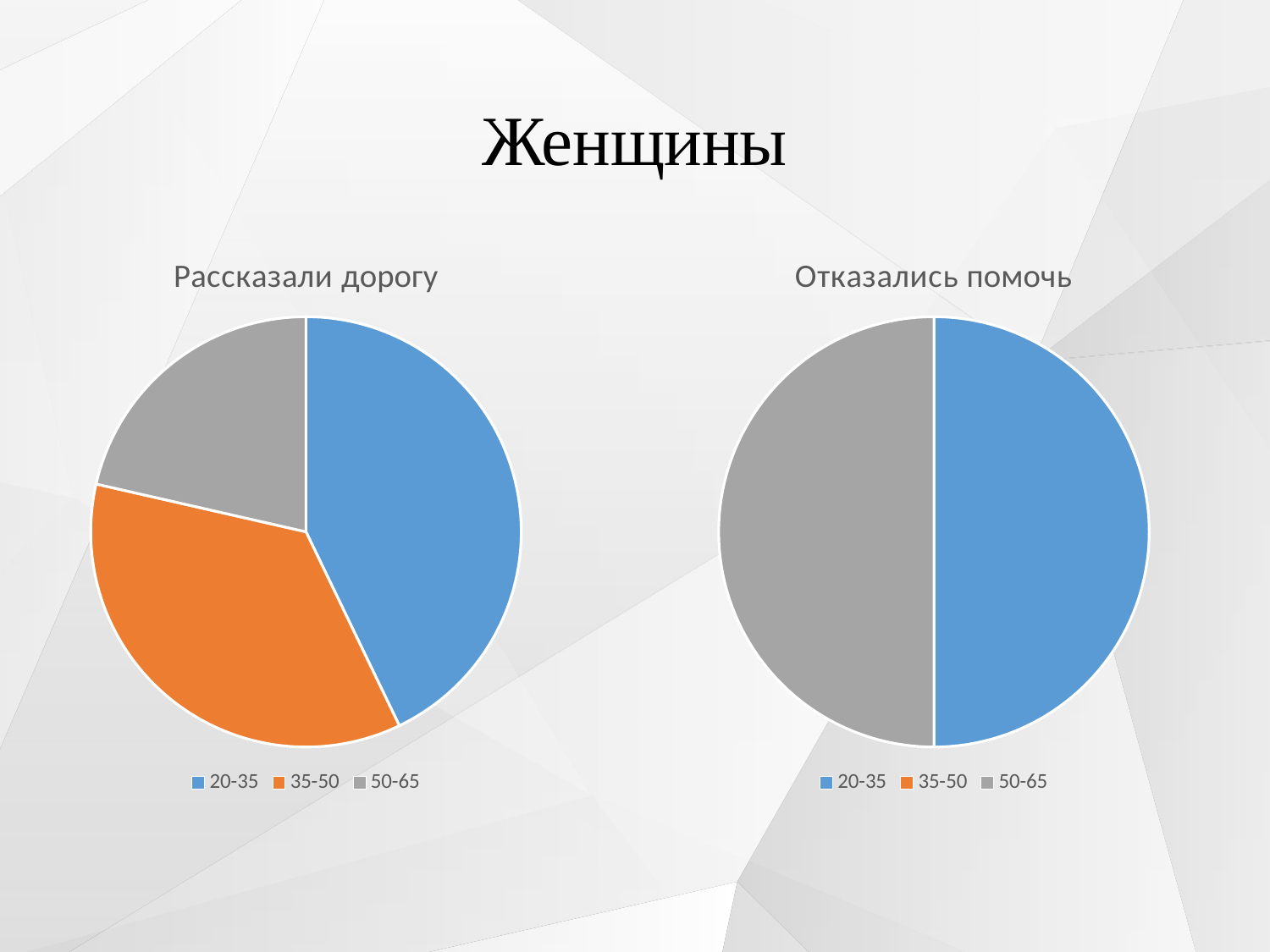
What is the title of the chart on the left of the slide? Рассказали дорогу In the "Отказались помочь" chart, which legend category has no visible slice in the pie? 35-50 In the "Отказались помочь" chart, how many slices are visible in the pie? 2 In the "Рассказали дорогу" chart, which slice is larger: 20-35 or 35-50? 20-35 In the "Отказались помочь" chart, how many entries does the legend list? 3 In the "Рассказали дорогу" chart, how many slices does the pie have? 3 What kind of chart is the "Отказались помочь" chart on the right? pie chart What kind of chart is the "Рассказали дорогу" chart on the left? pie chart In the "Рассказали дорогу" chart, how many entries does the legend list? 3 In the "Рассказали дорогу" chart, which age group has the largest slice? 20-35 In the "Рассказали дорогу" chart, which age group has the smallest slice? 50-65 In the "Рассказали дорогу" chart, which slice is larger: 35-50 or 50-65? 35-50